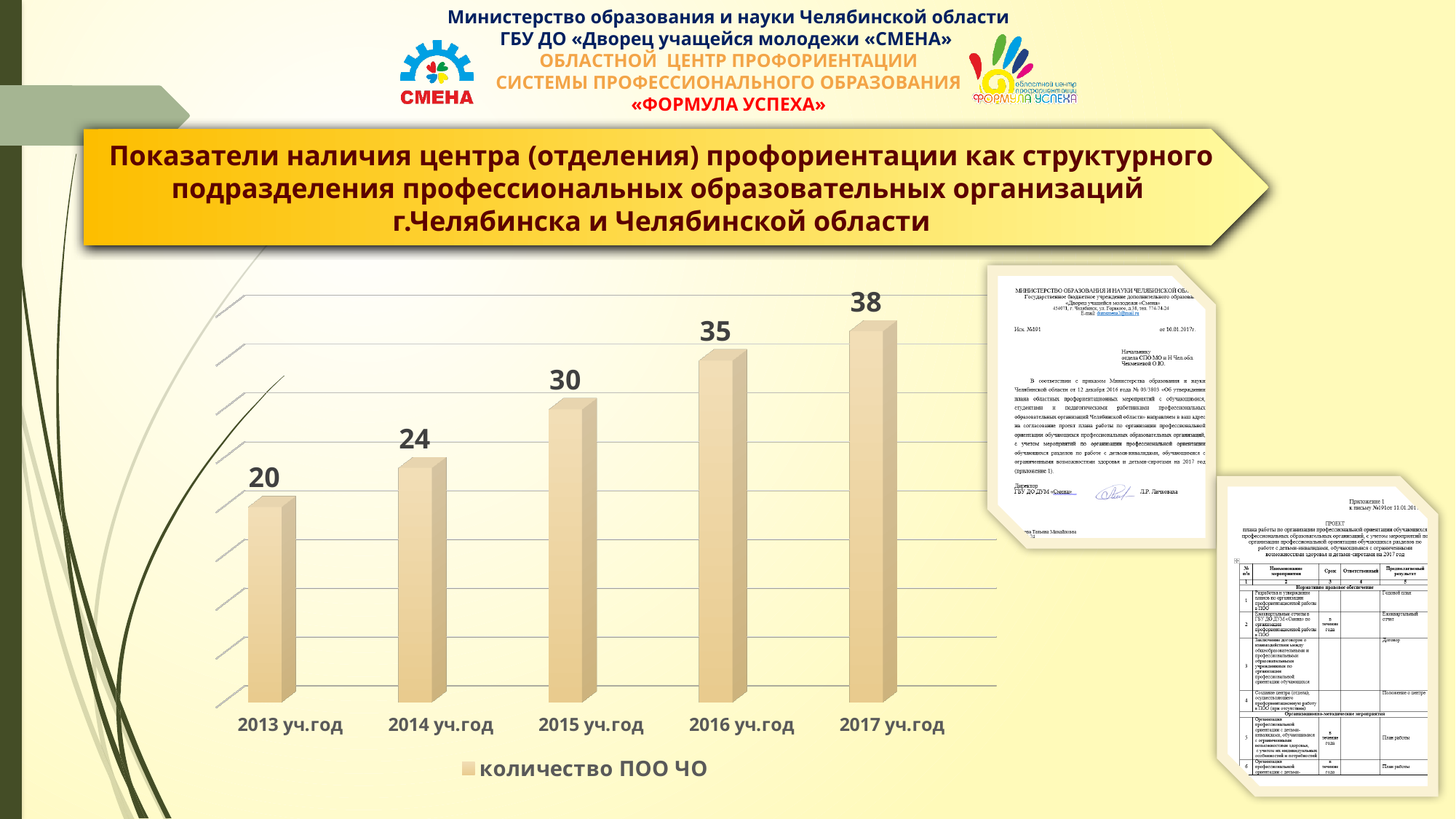
What is the difference between the values for 2016 уч.год and 2014 уч.год? 11 How many categories are shown on the x axis? 5 What is the value for 2013 уч.год? 20 Which is larger, the value for 2014 уч.год or 2015 уч.год? 2015 уч.год What kind of chart is shown? bar chart What is the value for 2017 уч.год? 38 Do the values rise or fall from 2013 уч.год to 2017 уч.год? rise What is the difference between the values for 2017 уч.год and 2013 уч.год? 18 Which year has the highest value? 2017 уч.год What is the value for 2015 уч.год? 30 Which year has the lowest value? 2013 уч.год How many series does the legend list? 1